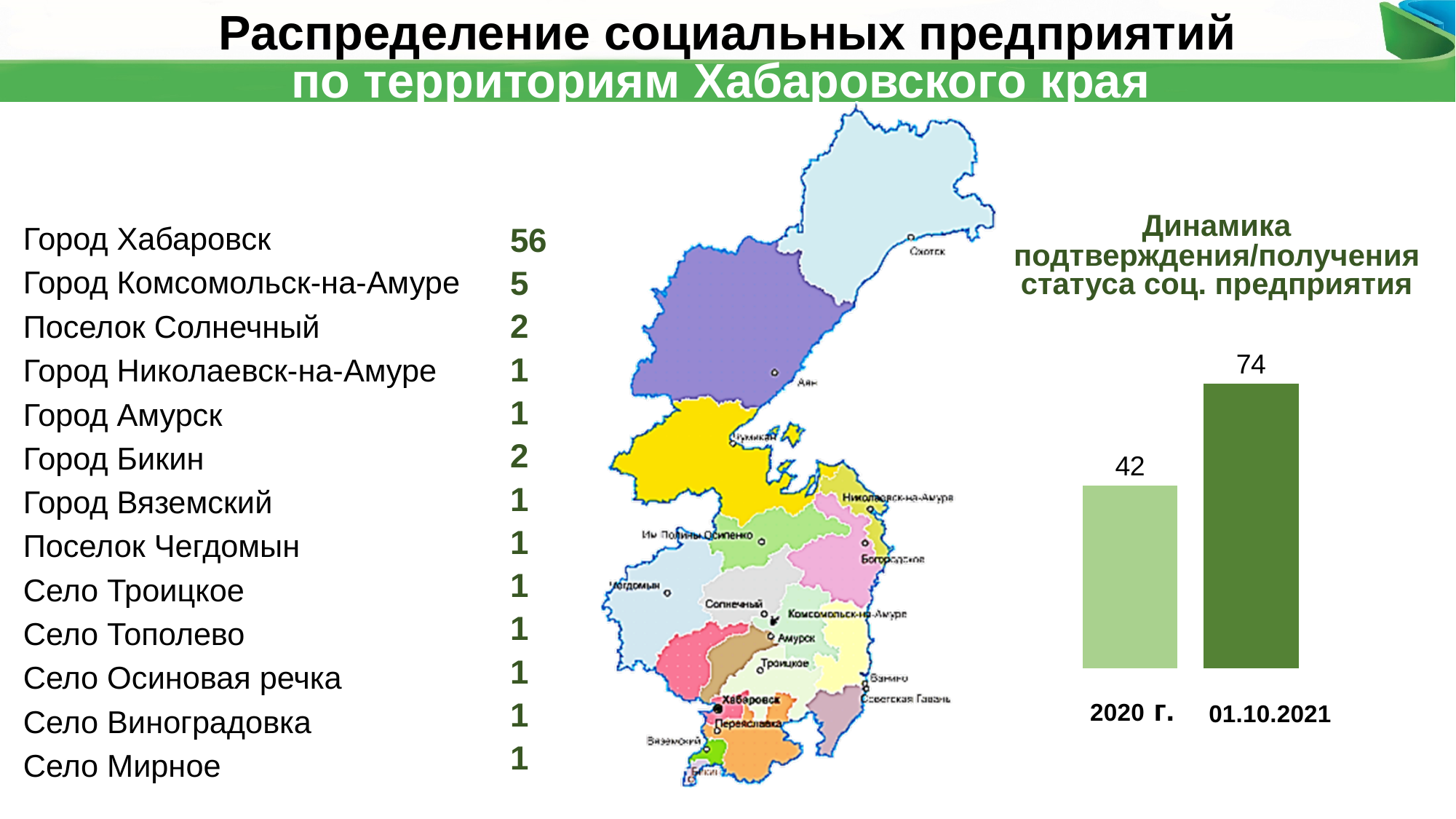
How many bars are shown in the bar chart? 2 What is the title of the bar chart? Динамика подтверждения/получения статуса соц. предприятия What is the value for 01.10.2021 in the bar chart? 74 Which is larger in the bar chart: the value for 2020 г. or the value for 01.10.2021? 01.10.2021 Which category has the lowest value in the bar chart? 2020 г. Which category has the highest value in the bar chart? 01.10.2021 What is the difference between the values for 01.10.2021 and 2020 г. in the bar chart? 32 Which bar in the bar chart is the darker green? 01.10.2021 Do the values in the bar chart rise or fall from 2020 г. to 01.10.2021? rise What kind of chart is shown on the right side of the slide? bar chart What is the value for 2020 г. in the bar chart? 42